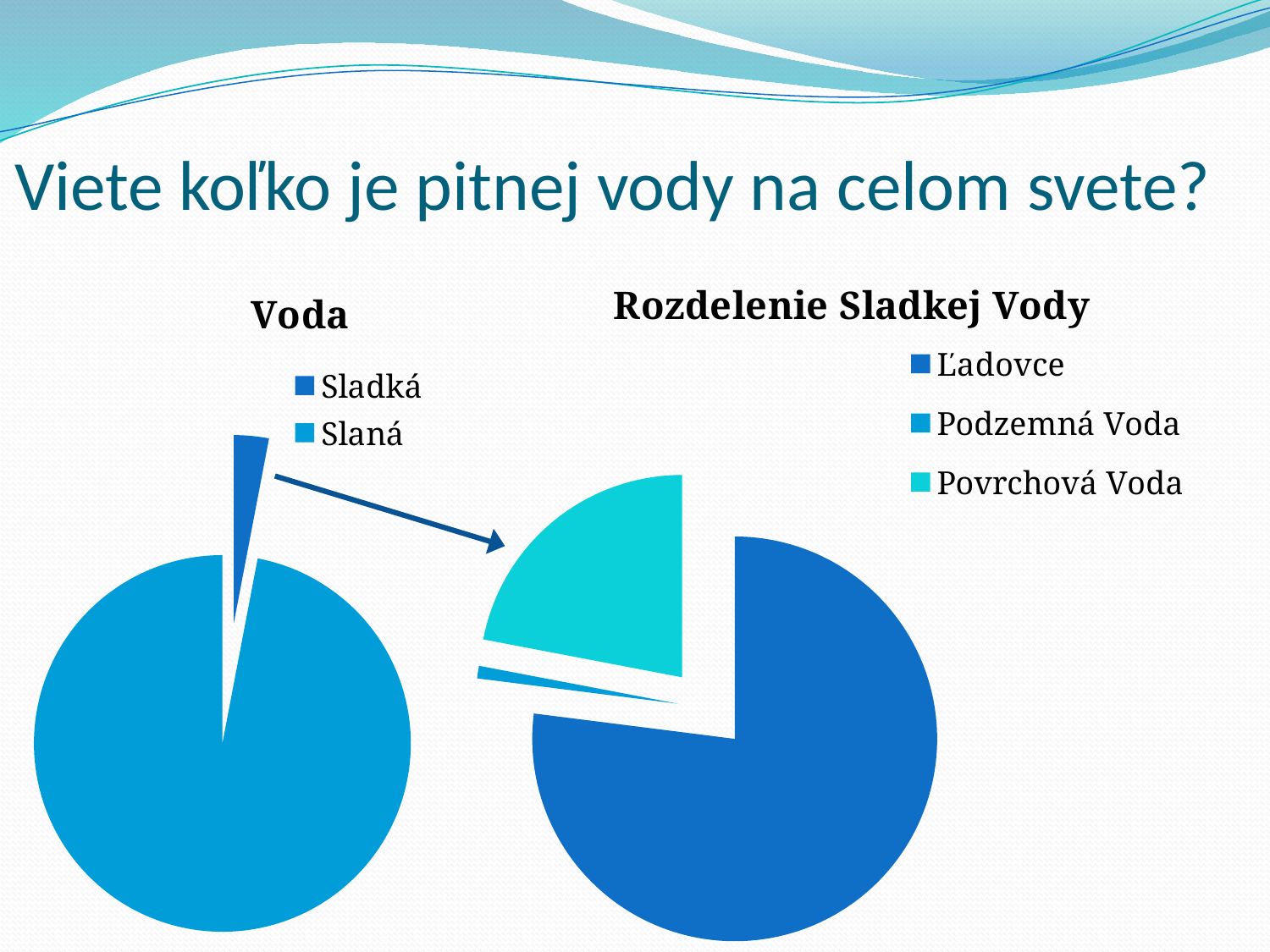
What kind of chart is the chart titled "Rozdelenie Sladkej Vody"? pie chart In the chart titled "Rozdelenie Sladkej Vody", which category has the largest slice? Ľadovce In the chart titled "Voda", how many slices does the pie have? 2 In the chart titled "Rozdelenie Sladkej Vody", which slice is larger: Povrchová Voda or Podzemná Voda? Povrchová Voda What kind of chart is the chart titled "Voda"? pie chart In the chart titled "Voda", which slice is larger: Sladká or Slaná? Slaná In the chart titled "Rozdelenie Sladkej Vody", which category has the smallest slice? Podzemná Voda In the chart titled "Voda", which category has the largest slice? Slaná What is the title of the pie chart on the right side of the slide? Rozdelenie Sladkej Vody In the chart titled "Voda", which category has the smallest slice? Sladká In the chart titled "Rozdelenie Sladkej Vody", which category is shown in the lightest (cyan) colour? Povrchová Voda In the chart titled "Rozdelenie Sladkej Vody", how many categories does the legend list? 3